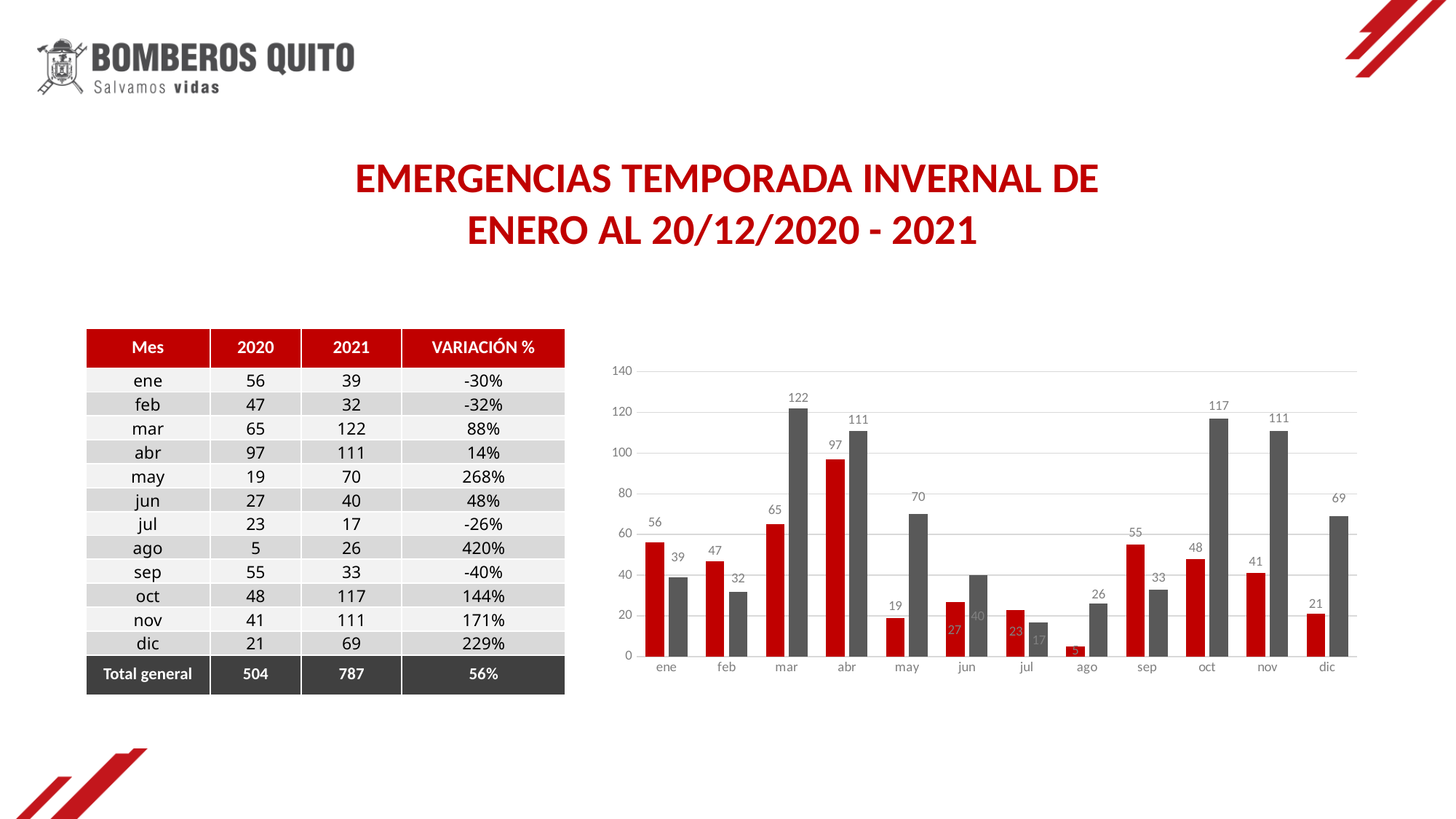
Which month has the lowest red bar in the chart? ago What is the difference between the grey bar and the red bar for may in the chart? 51 What type of chart is shown on the slide? bar chart Which is larger for sep in the chart, the red bar or the grey bar? the red bar What is the value of the grey bar for mar in the chart? 122 What colour are the bars representing 2020 in the chart? red What is the value of the grey bar for oct in the chart? 117 Is the value of the grey bar for nov greater or less than 100? greater How many months are shown on the x axis of the chart? 12 Which month has the highest grey bar in the chart? mar How many bars are plotted for each month in the chart? 2 What is the value of the red bar for abr in the chart? 97